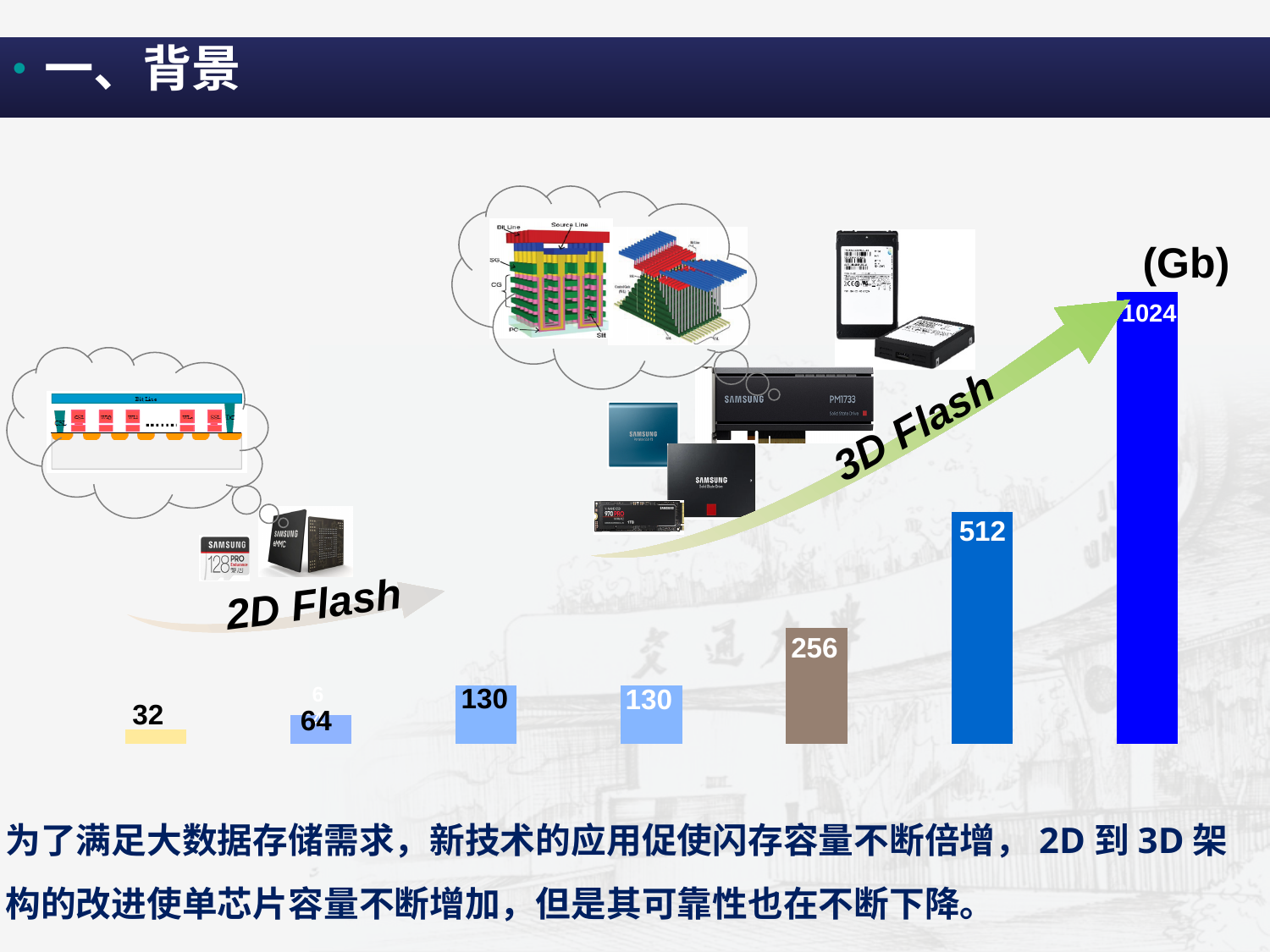
What value is labelled on the second bar from the left? 64 Do the bar values generally rise or fall from left to right? rise What is the value of the tallest bar in the chart? 1024 What is the value of the shortest bar in the chart? 32 What value is labelled on the brown bar in the chart? 256 How many bars are plotted in the chart? 7 What kind of chart is shown on the slide? bar chart What value is labelled on the leftmost bar of the chart? 32 What unit is shown next to the chart for the bar values? Gb Which is larger, the bar labelled 256 or the bar labelled 130? 256 What is the difference between the rightmost bar (1024) and the bar labelled 512? 512 What value is labelled on the second bar from the right? 512